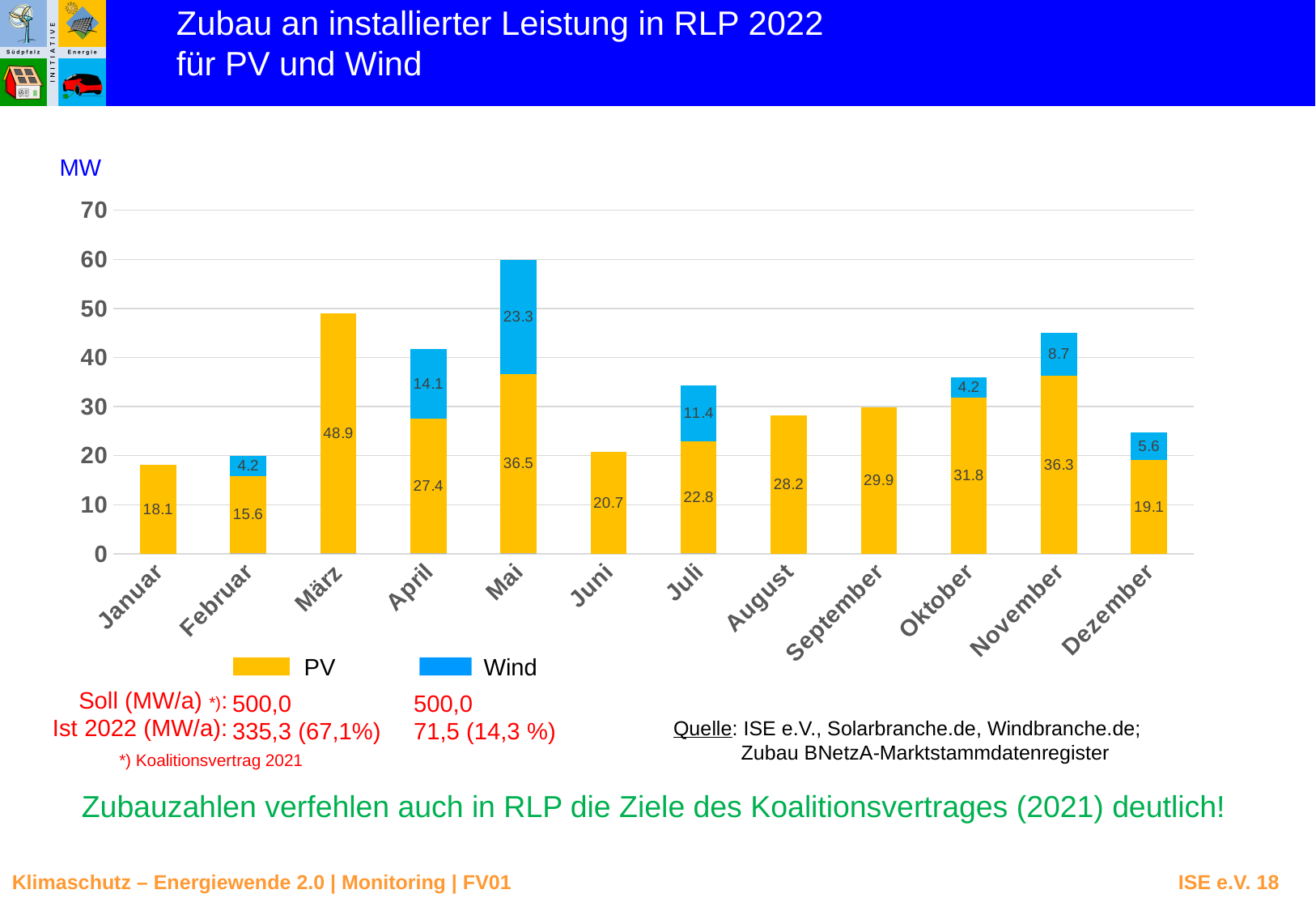
What is the difference between the PV values for November and Januar? 18.2 What is the total of the stacked bar for April? 41.5 What is the total of the stacked bar for Mai? 59.8 Which month has the lowest PV value? Februar Which month has the highest PV value? März What is the Wind value for Mai? 23.3 How many series does the legend list? 2 What is the PV value for März? 48.9 What is the PV value for Dezember? 19.1 How many months are shown on the x axis? 12 What kind of chart is shown on the slide? Stacked bar chart Which is larger, the Wind value for April or the Wind value for Juli? April